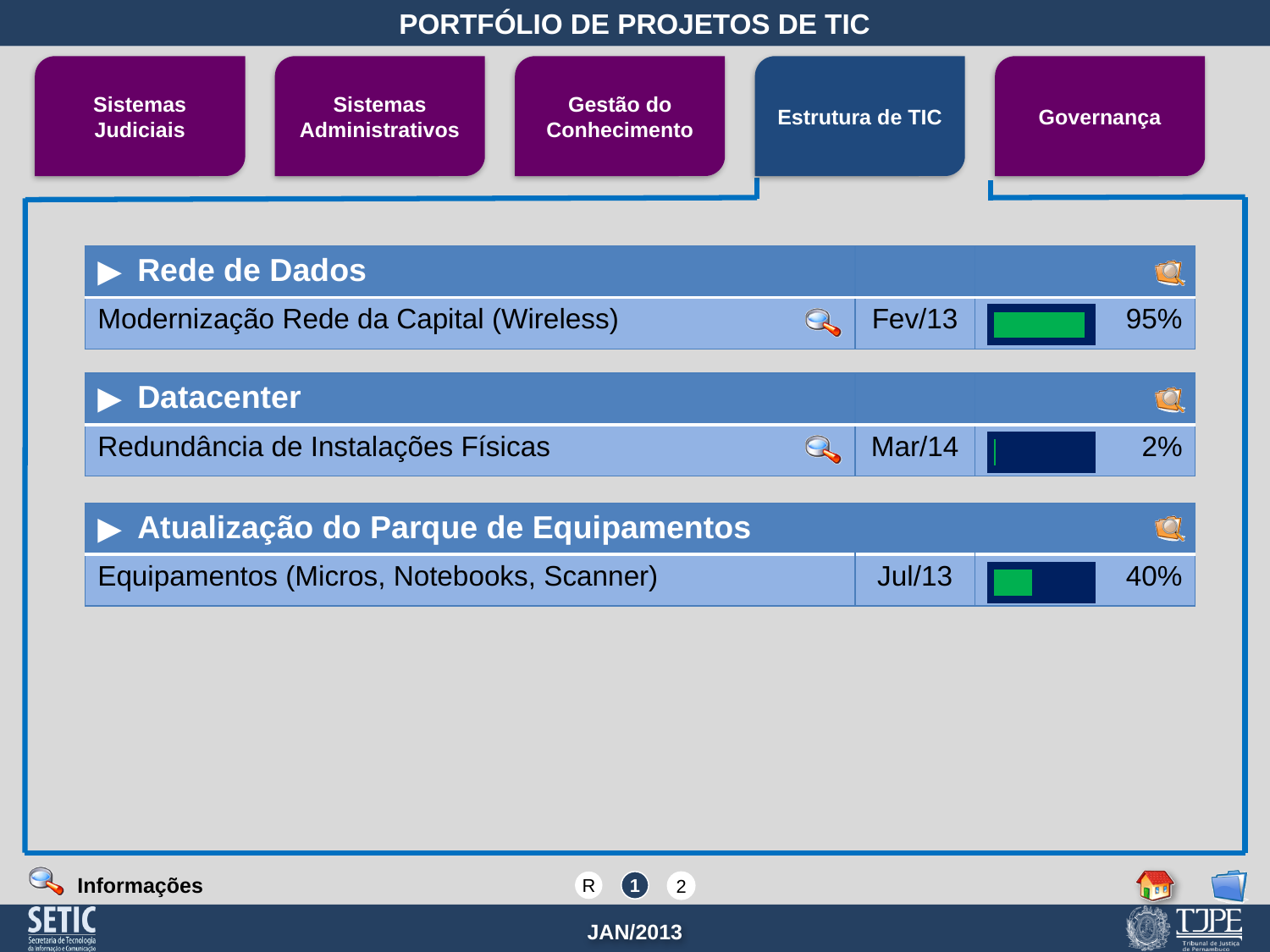
What date is shown next to the project 'Redundância de Instalações Físicas'? Mar/14 Which project has the highest completion percentage on the slide? Modernização Rede da Capital (Wireless) What date is shown next to the project 'Equipamentos (Micros, Notebooks, Scanner)'? Jul/13 What completion percentage is shown for the project 'Redundância de Instalações Físicas'? 2% How many projects with progress bars are listed on the slide? 3 What completion percentage is shown for the project 'Equipamentos (Micros, Notebooks, Scanner)'? 40% Which project has a larger completion percentage, 'Redundância de Instalações Físicas' or 'Equipamentos (Micros, Notebooks, Scanner)'? Equipamentos (Micros, Notebooks, Scanner) What is the difference in completion percentage between 'Equipamentos (Micros, Notebooks, Scanner)' and 'Redundância de Instalações Físicas'? 38% What is the difference in completion percentage between 'Modernização Rede da Capital (Wireless)' and 'Equipamentos (Micros, Notebooks, Scanner)'? 55% What completion percentage is shown for the project 'Modernização Rede da Capital (Wireless)'? 95% Which project has the lowest completion percentage on the slide? Redundância de Instalações Físicas Under which group heading is the project 'Modernização Rede da Capital (Wireless)' listed? Rede de Dados